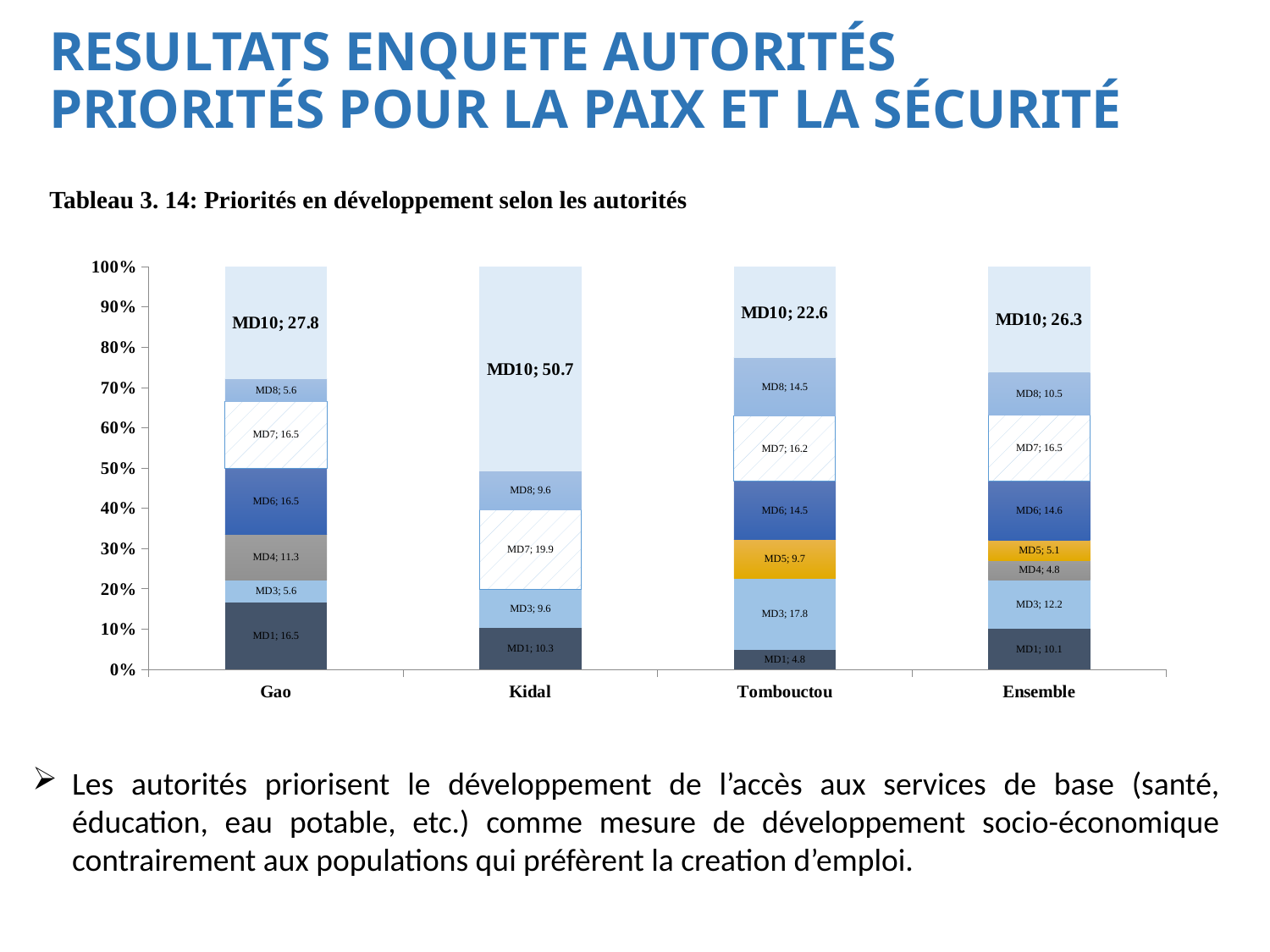
Which category has the lowest value for MD1? Tombouctou What is the value of MD8 for Ensemble? 10.5 What is the difference between the MD10 values for Kidal and Tombouctou? 28.1 Which is larger, MD7 for Kidal or MD7 for Gao? MD7 for Kidal What is the title of the chart? Tableau 3. 14: Priorités en développement selon les autorités How many categories are shown on the x axis? 4 What is the value of MD5 for Tombouctou? 9.7 Which category has the highest value for MD10? Kidal What kind of chart is shown on the slide? Stacked bar chart What is the value of MD10 for Kidal? 50.7 What is the value of MD3 for Tombouctou? 17.8 What is the value of MD1 for Gao? 16.5